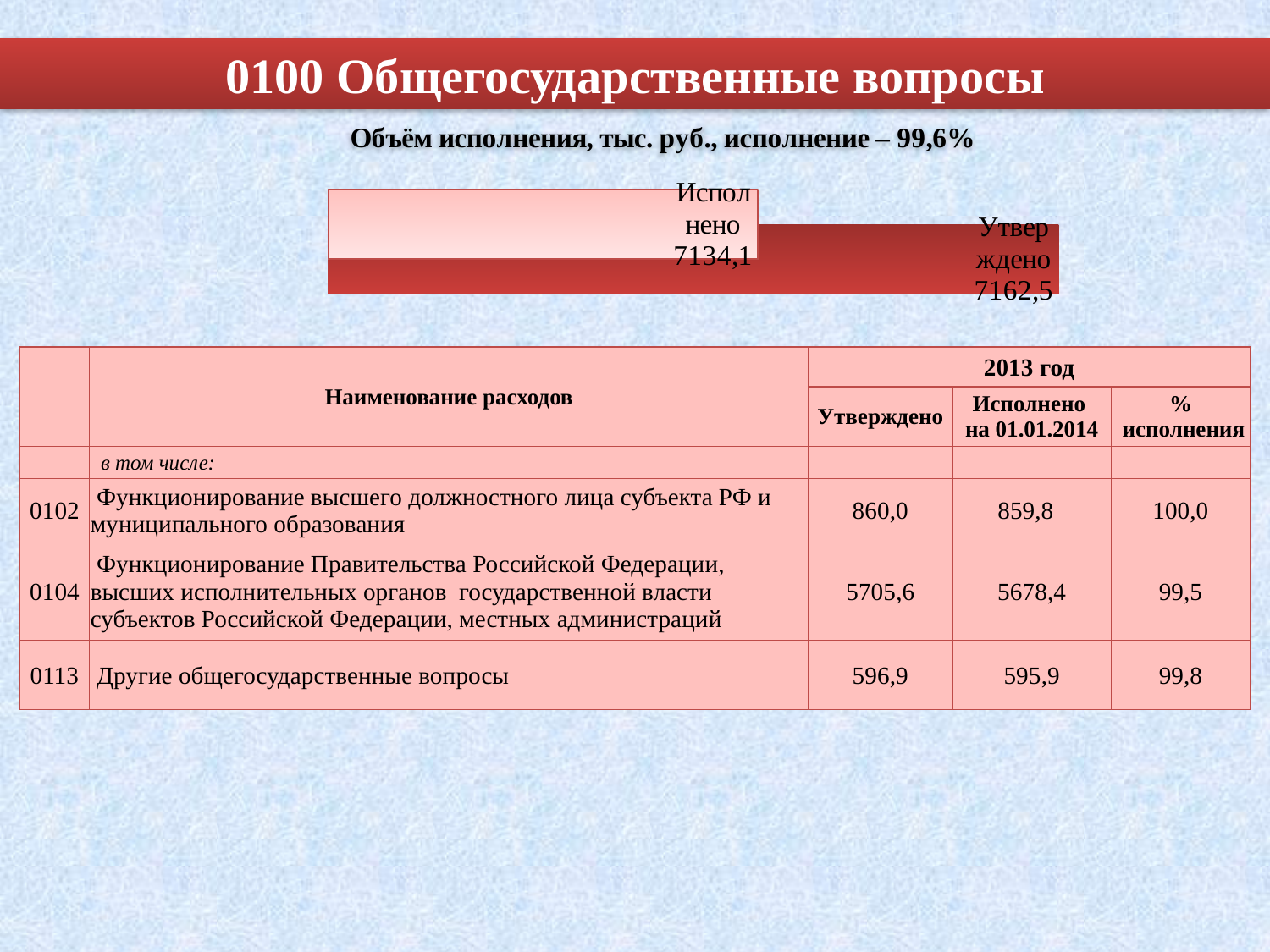
What is the value shown for Утверждено on the bar chart? 7162,5 What is the title text above the chart? Объём исполнения, тыс. руб., исполнение – 99,6% Which bar on the chart has the higher value? Утверждено What unit of measurement does the chart title state for the values? тыс. руб. How many bars are plotted on the chart? 2 Is the value for Исполнено larger or smaller than the value for Утверждено? smaller What type of chart is shown on the slide? bar chart Which bar on the chart has the lower value? Исполнено What is the value shown for Исполнено on the bar chart? 7134,1 What is the difference between the Утверждено and Исполнено values on the chart? 28,4